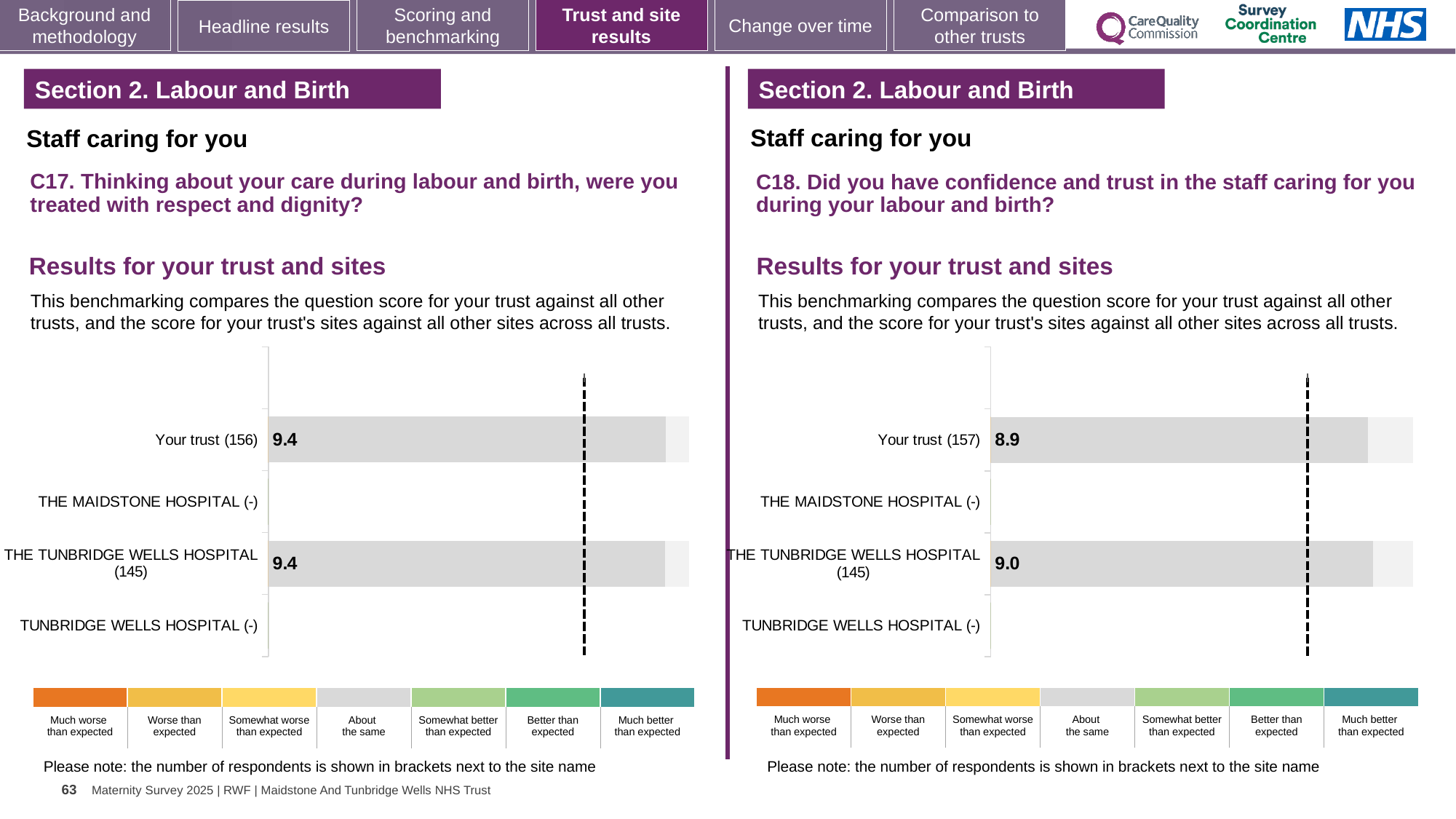
What type of chart is used for the C17 results on the left? Bar chart How many respondents are shown in brackets for Your trust in the C18 chart on the right? 157 In the C18 chart on the right, what is the score for THE TUNBRIDGE WELLS HOSPITAL (145)? 9.0 In the C18 chart on the right, how many categories have a plotted bar with a score? 2 In the C18 chart on the right, what is the score for Your trust (157)? 8.9 In the C17 chart on the left, what is the score for THE TUNBRIDGE WELLS HOSPITAL (145)? 9.4 In the C17 chart on the left, what is the difference between the score for Your trust (156) and the score for THE TUNBRIDGE WELLS HOSPITAL (145)? 0 In the C18 chart on the right, what is the difference between the score for THE TUNBRIDGE WELLS HOSPITAL (145) and the score for Your trust (157)? 0.1 In the C17 chart on the left, what is the score for Your trust (156)? 9.4 How many categories are listed on the vertical axis of the C17 chart on the left? 4 In the C18 chart on the right, which has the higher score: Your trust (157) or THE TUNBRIDGE WELLS HOSPITAL (145)? THE TUNBRIDGE WELLS HOSPITAL (145) How many benchmark categories are shown in the colour key below the C17 chart on the left? 7